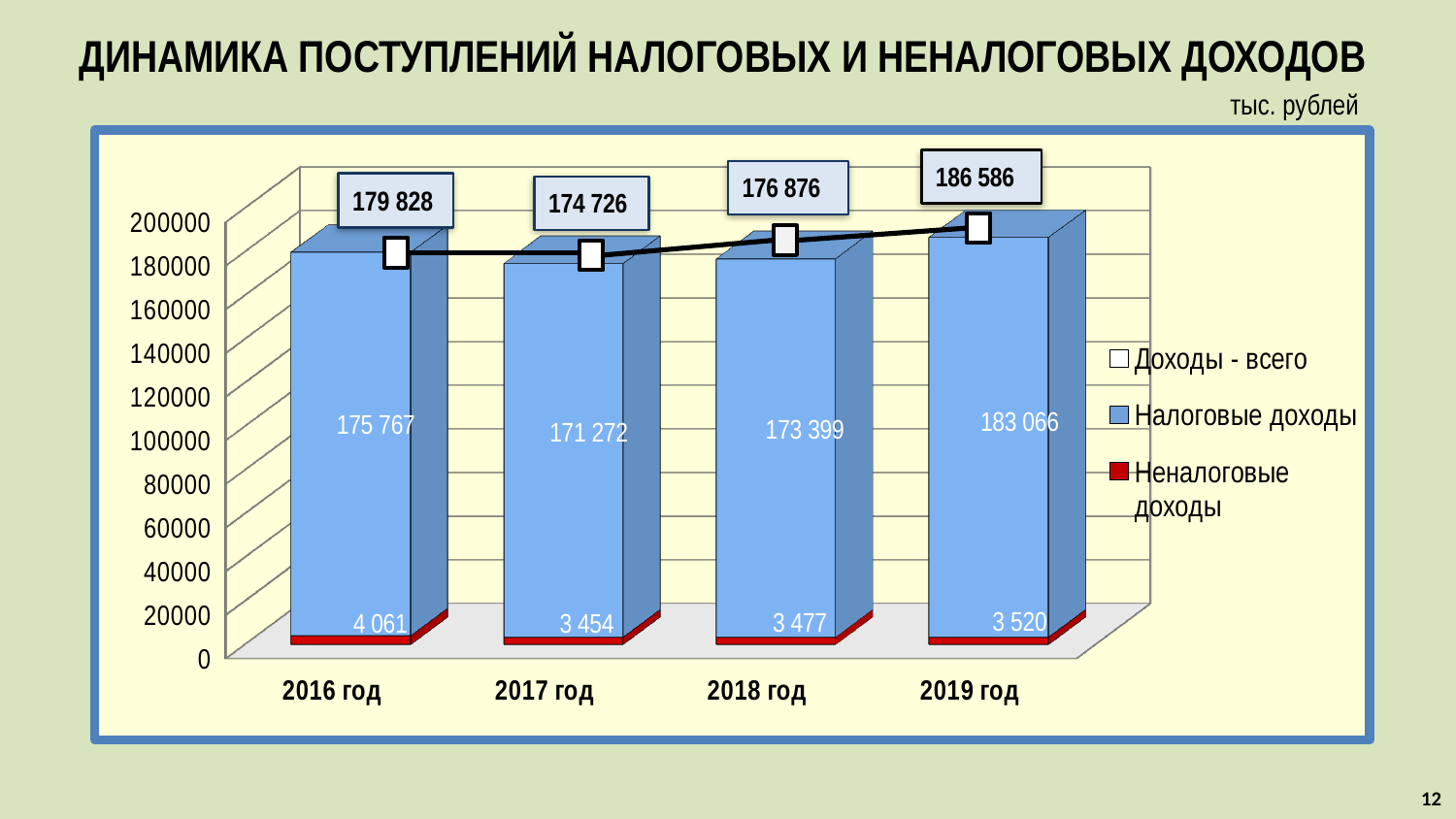
What is the value of Налоговые доходы for 2019 год? 183 066 What kind of chart is shown on the slide? Bar chart with a line What is the value of Доходы - всего for 2017 год? 174 726 How many series does the legend list? 3 How many years are shown on the x axis? 4 What is the difference between Доходы - всего in 2019 год and 2018 год? 9 710 Which year has the highest value of Доходы - всего? 2019 год Which year has the lowest value of Налоговые доходы? 2017 год Does Доходы - всего rise or fall from 2017 год to 2019 год? Rise Which is larger: Неналоговые доходы in 2018 год or in 2019 год? 2019 год What unit is stated above the chart? тыс. рублей What is the value of Неналоговые доходы for 2016 год? 4 061